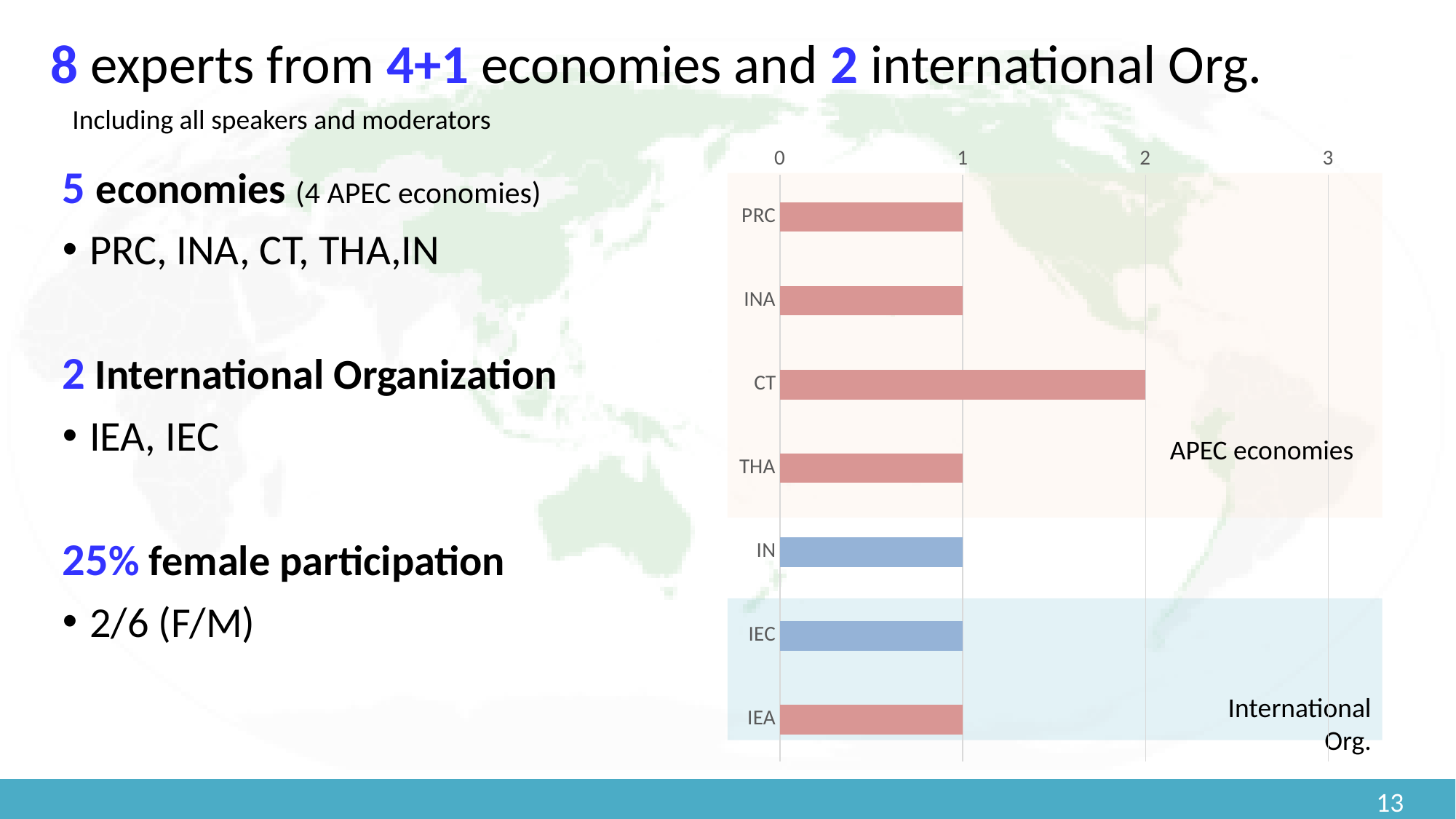
Is the value for CT greater or less than 3? less Which category has the highest value in the bar chart? CT What is the value for CT in the bar chart? 2 What is the highest tick value shown on the chart's horizontal axis? 3 Which is larger, the value for CT or the value for INA? CT What is the value for IEA in the bar chart? 1 What kind of chart is shown on the slide? bar chart Which two categories in the bar chart are drawn in blue rather than red? IN and IEC What is the value for PRC in the bar chart? 1 How many categories are plotted in the bar chart? 7 What is the difference between the values for CT and THA? 1 What is the value for IN in the bar chart? 1